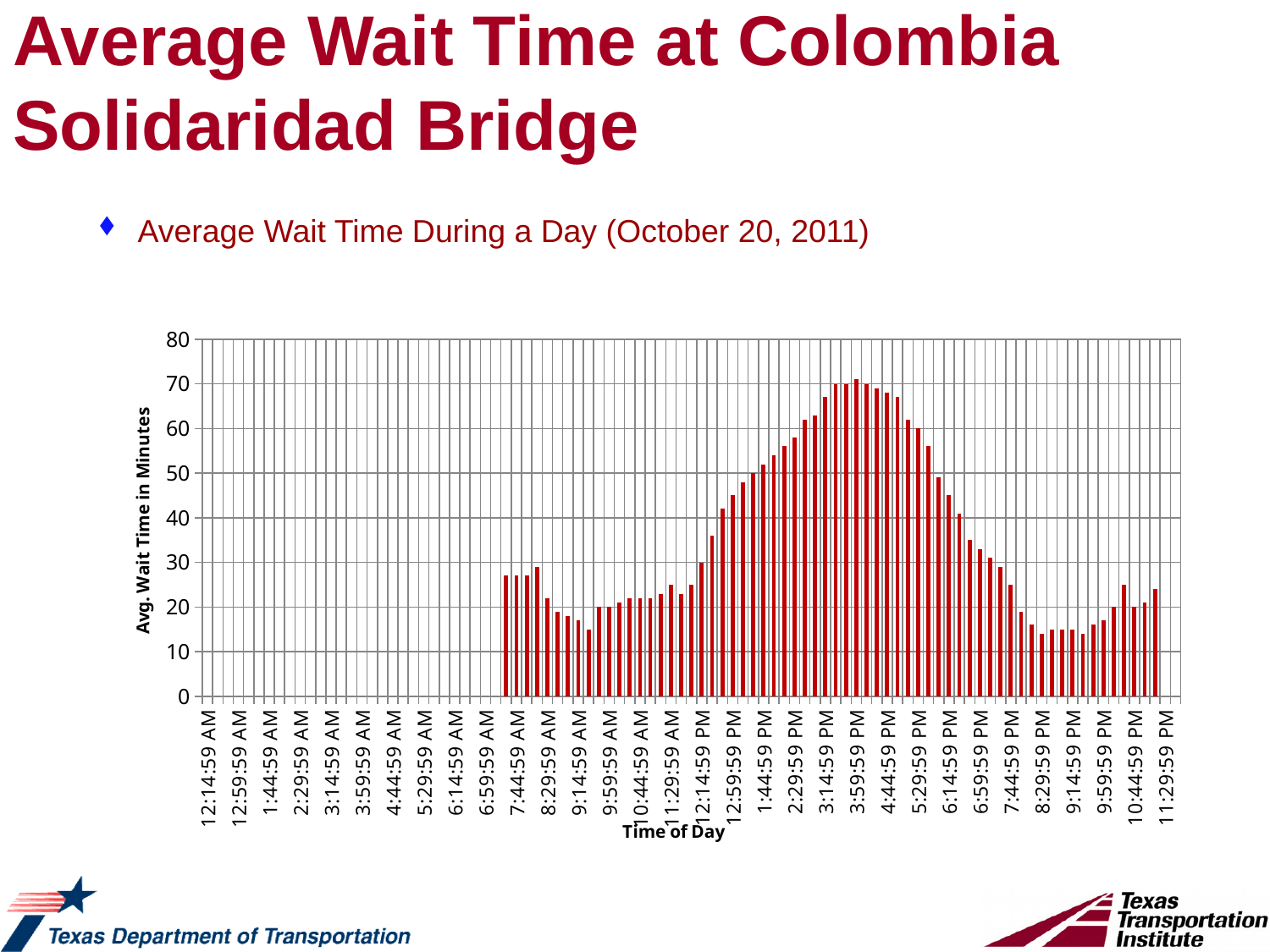
Is the value for 8:29:59 PM greater or less than 20? less Is the value for 9:14:59 AM greater or less than 20? less Around which time of day is the average wait time highest? 3:59:59 PM Do the values rise or fall between 3:59:59 PM and 8:29:59 PM? fall What is the label of the horizontal axis? Time of Day Do the values rise or fall between 12:14:59 PM and 3:59:59 PM? rise Is the value for 2:29:59 PM greater or less than 50? greater What kind of chart is shown on the slide? Bar chart What is the label of the vertical axis? Avg. Wait Time in Minutes